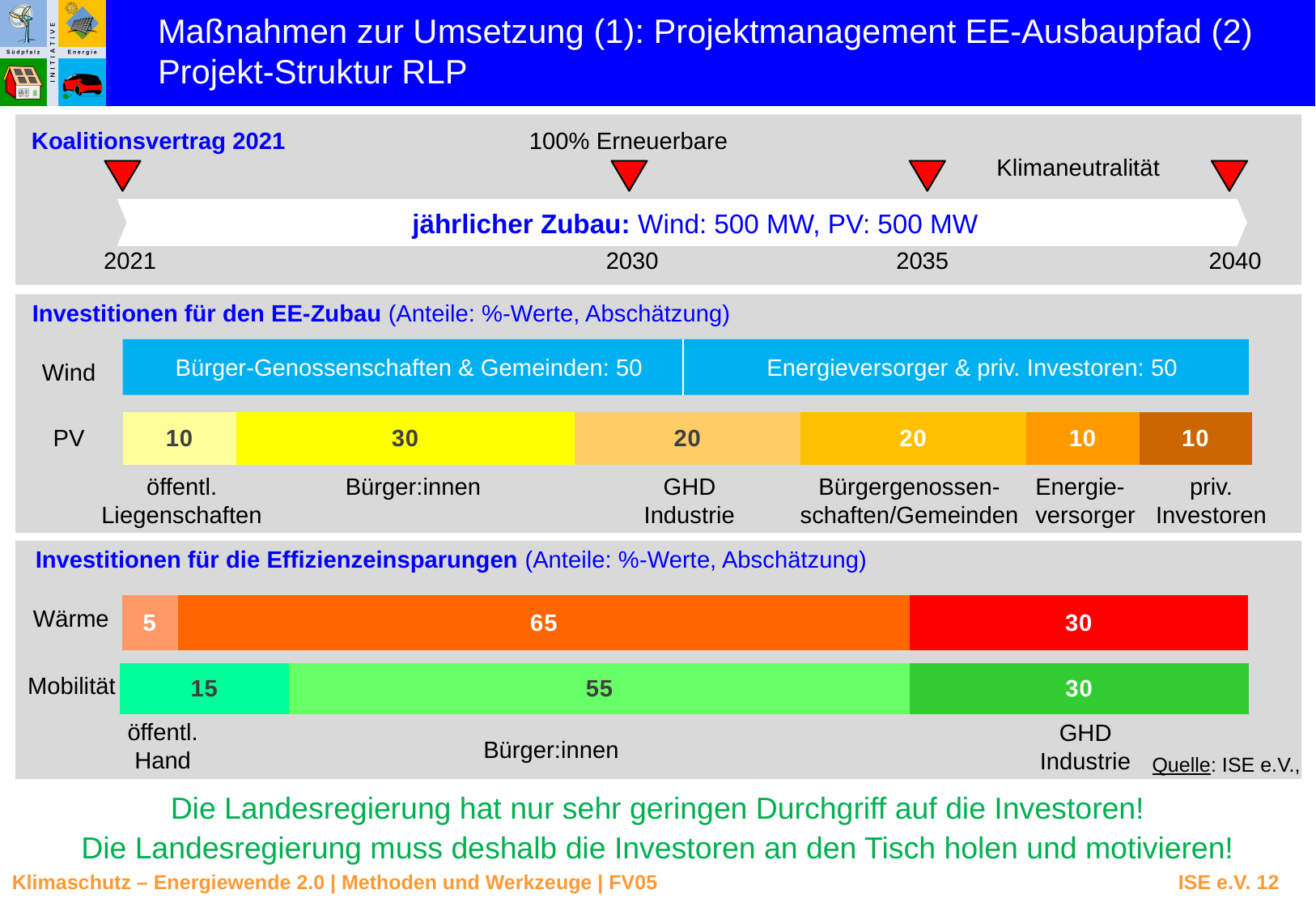
In the chart 'Investitionen für den EE-Zubau', how many segments make up the PV bar? 6 In the chart 'Investitionen für die Effizienzeinsparungen', what share of Mobilität investment is attributed to öffentl. Hand? 15 In the chart 'Investitionen für die Effizienzeinsparungen', which is larger: the Bürger:innen share for Wärme or for Mobilität? Wärme In the chart 'Investitionen für den EE-Zubau', what is the difference between the PV shares of Bürger:innen and GHD Industrie? 10 In the chart 'Investitionen für die Effizienzeinsparungen', which investor group has the smallest share for Wärme? öffentl. Hand In the chart 'Investitionen für den EE-Zubau', what share of Wind investment is attributed to Energieversorger & priv. Investoren? 50 In the chart 'Investitionen für den EE-Zubau', which PV investor group has the largest share? Bürger:innen In the chart 'Investitionen für die Effizienzeinsparungen', what is the total of the Mobilität bar? 100 What kind of chart is used in the 'Investitionen für die Effizienzeinsparungen' section? Stacked bar chart In the chart 'Investitionen für den EE-Zubau', what share of PV investment is attributed to Bürger:innen? 30 In the chart 'Investitionen für die Effizienzeinsparungen', what is the difference between the öffentl. Hand shares for Mobilität and Wärme? 10 In the chart 'Investitionen für die Effizienzeinsparungen', what share of Wärme investment is attributed to Bürger:innen? 65